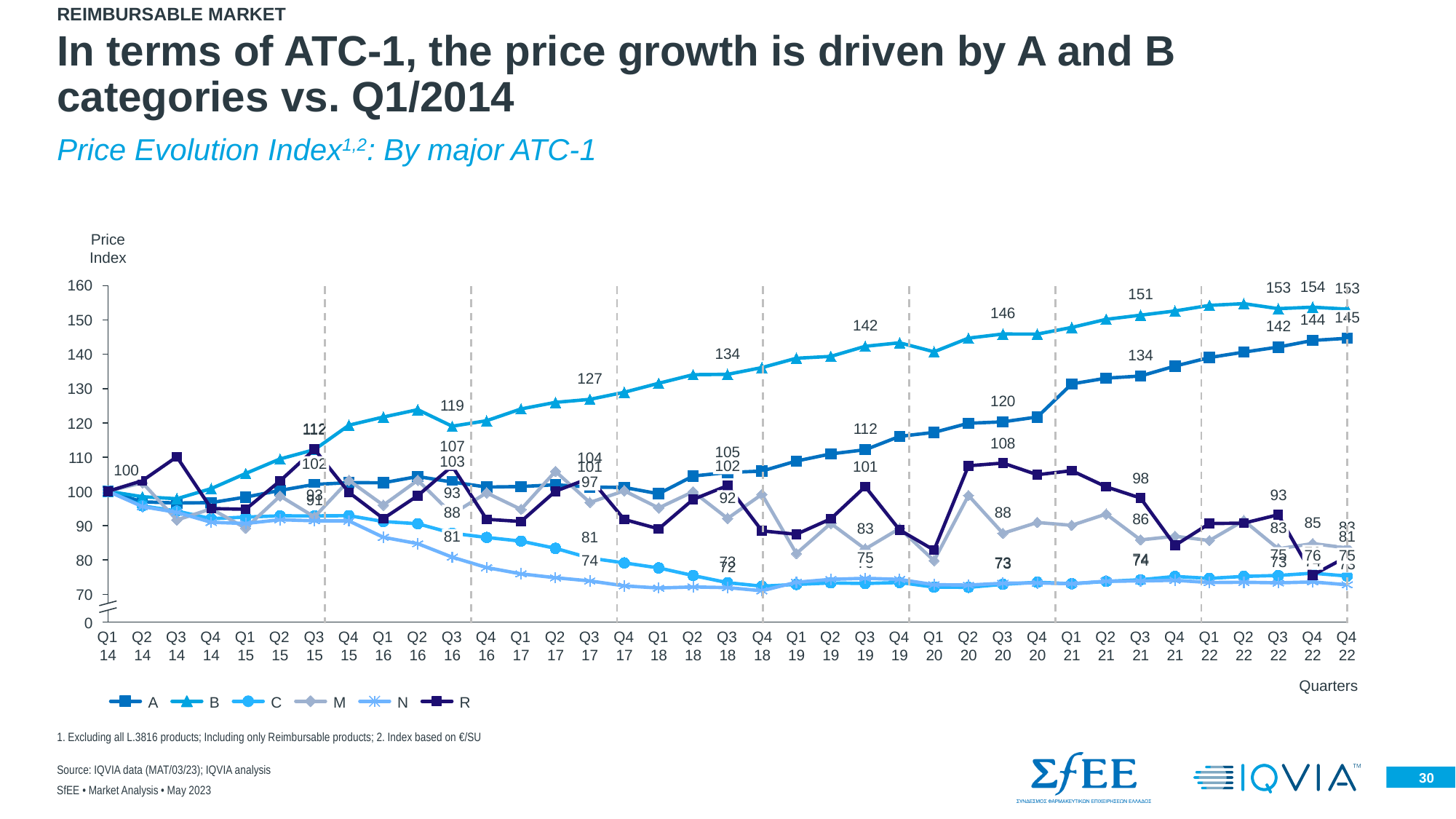
How many series does the legend list? 6 Is the price index for series C in Q3 2022 greater or less than 80? less What is the price index value for series A in Q3 2021? 134 Which series has the highest price index in Q3 2022? B What is the price index value for series B in Q3 2019? 142 What is the price index value for series A in Q3 2022? 142 What kind of chart is shown on the slide? line chart In Q3 2020, which series has the higher price index, A or R? A Does the price index for series B generally rise or fall from Q1 2014 to the end of the period? rise What is the price index value for series B in Q3 2016? 119 What is the difference between the price index of series B and series A in Q3 2021? 17 By how much did the price index of series B increase from Q3 2016 to Q3 2022? 34